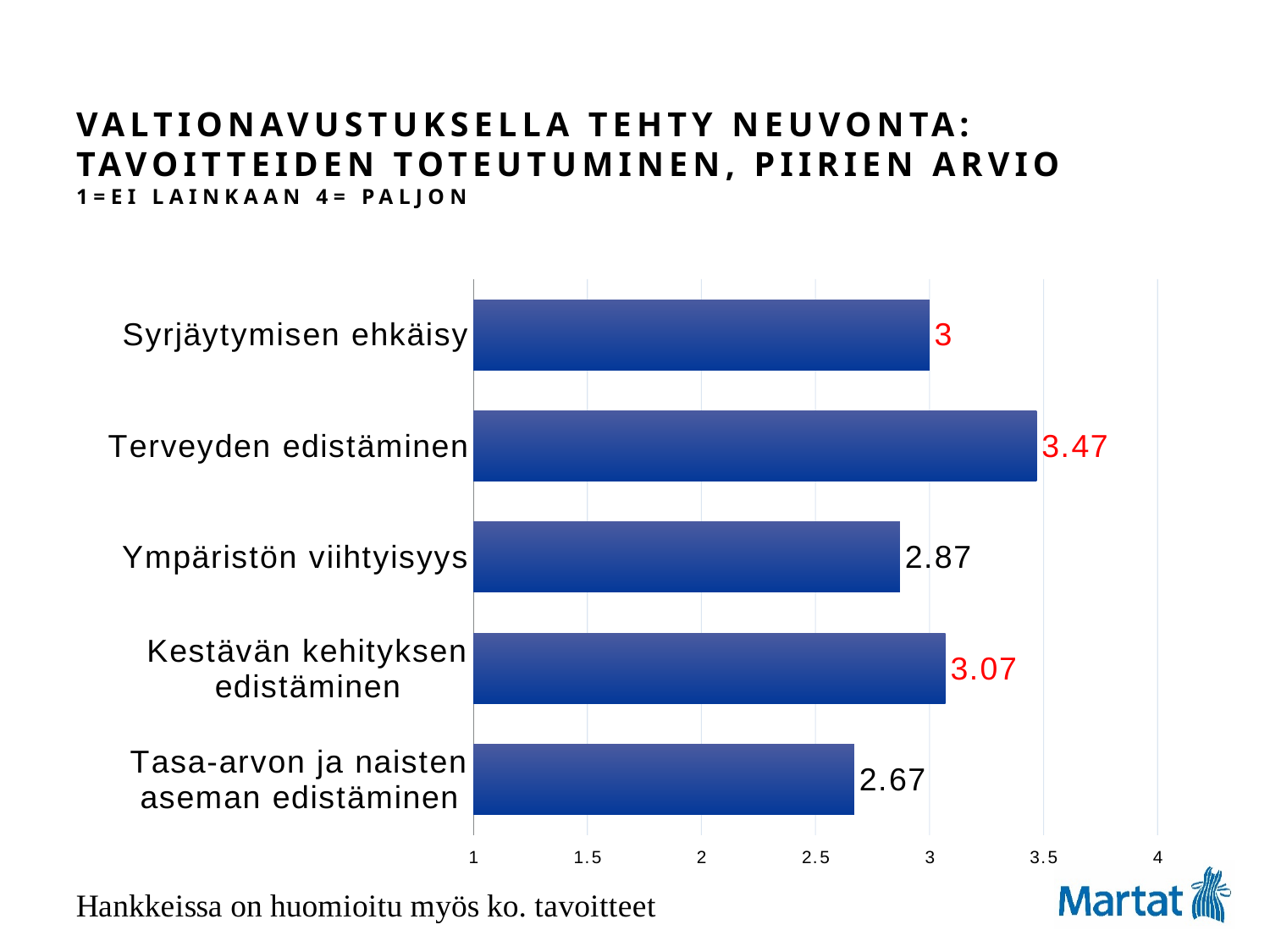
What is the value for Ympäristön viihtyisyys? 2.87 What is the difference between the values for Terveyden edistäminen and Syrjäytymisen ehkäisy? 0.47 What is the maximum value shown on the x axis? 4 Is the value for Tasa-arvon ja naisten aseman edistäminen greater or less than 3? less Which category has the lowest value? Tasa-arvon ja naisten aseman edistäminen Which category has the highest value? Terveyden edistäminen Which is larger, the value for Kestävän kehityksen edistäminen or the value for Ympäristön viihtyisyys? Kestävän kehityksen edistäminen What kind of chart is shown on the slide? bar chart What is the value for Tasa-arvon ja naisten aseman edistäminen? 2.67 What is the value for Kestävän kehityksen edistäminen? 3.07 What is the value for Terveyden edistäminen? 3.47 How many categories are shown in the chart? 5